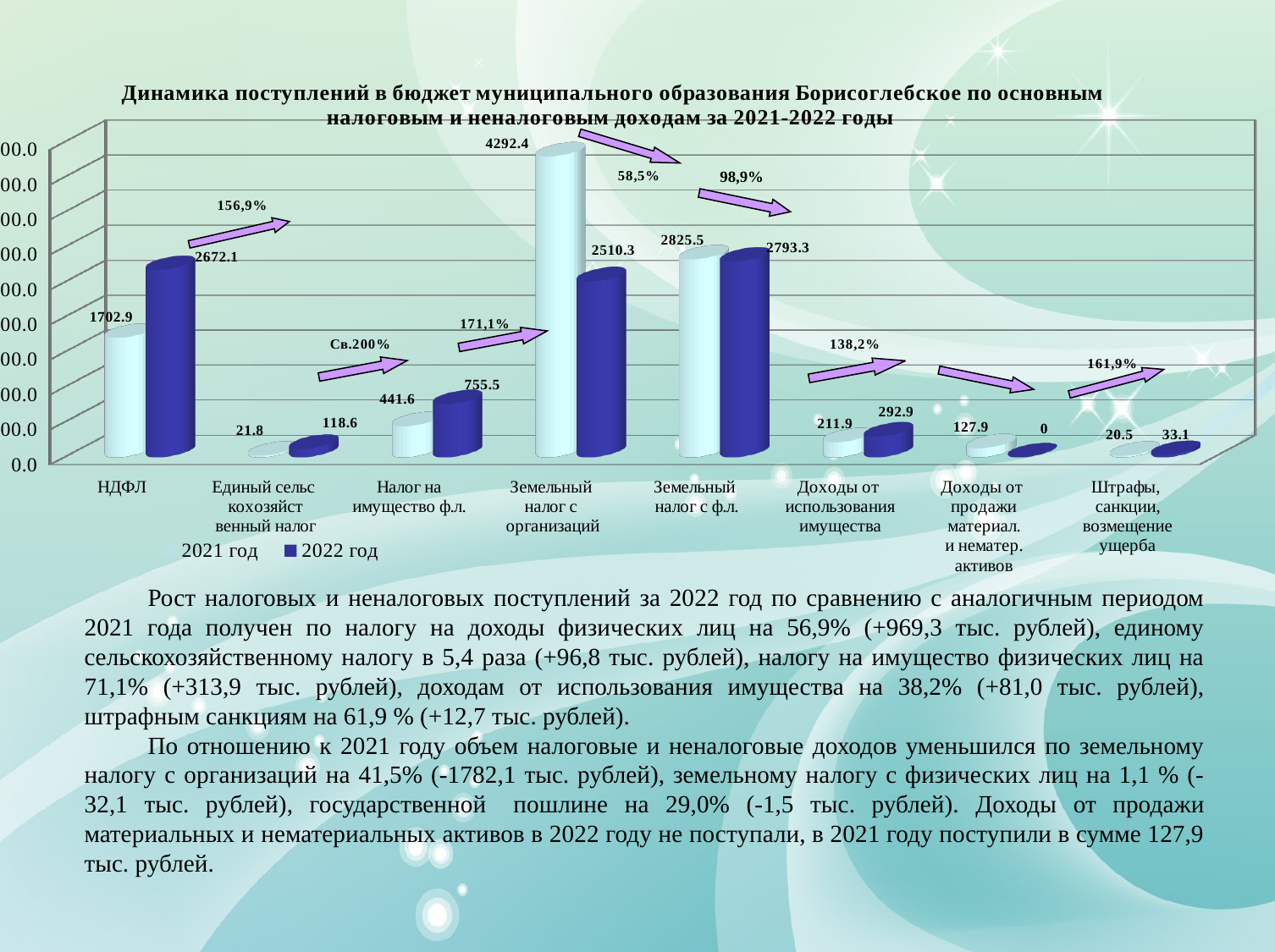
How many categories are shown on the x axis? 8 How many series does the legend list? 2 What is the value for НДФЛ in the 2022 год series? 2672.1 What is the value for Штрафы, санкции, возмещение ущерба in the 2021 год series? 20.5 What is the value for Доходы от продажи материал. и нематер. активов in the 2022 год series? 0 What is the value for Земельный налог с организаций in the 2021 год series? 4292.4 Which category has the highest value in the 2021 год series? Земельный налог с организаций What kind of chart is shown on the slide? Bar chart Which category has the lowest value in the 2022 год series? Доходы от продажи материал. и нематер. активов What is the difference between the 2022 год and 2021 год values for Налог на имущество ф.л.? 313.9 Which is larger for Единый сельскохозяйственный налог: the 2021 год value or the 2022 год value? 2022 год What is the difference between the 2021 год and 2022 год values for Земельный налог с организаций? 1782.1